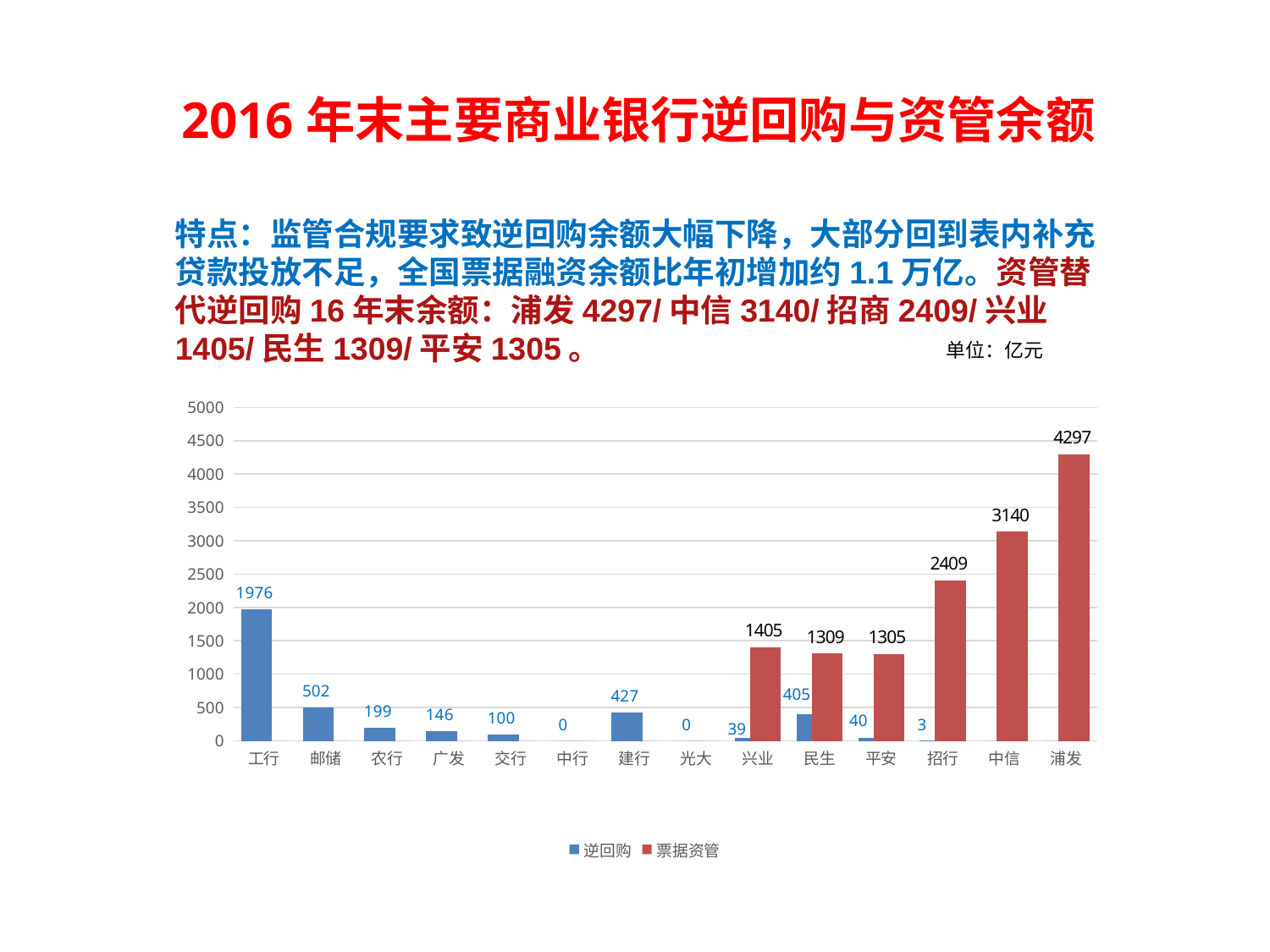
What is the 逆回购 value for 工行? 1976 Which bank has the highest 逆回购 value? 工行 Which bank has the highest 票据资管 value? 浦发 How many series does the legend list? 2 What is the 票据资管 value for 中信? 3140 Which is larger, the 逆回购 value for 民生 or the 逆回购 value for 邮储? 邮储 What kind of chart is shown on the slide? bar chart What unit is stated for the chart values? 亿元 How many banks are shown on the x axis? 14 What is the 逆回购 value for 建行? 427 What is the difference between the 逆回购 values for 工行 and 邮储? 1474 What is the difference between the 票据资管 values for 浦发 and 招行? 1888